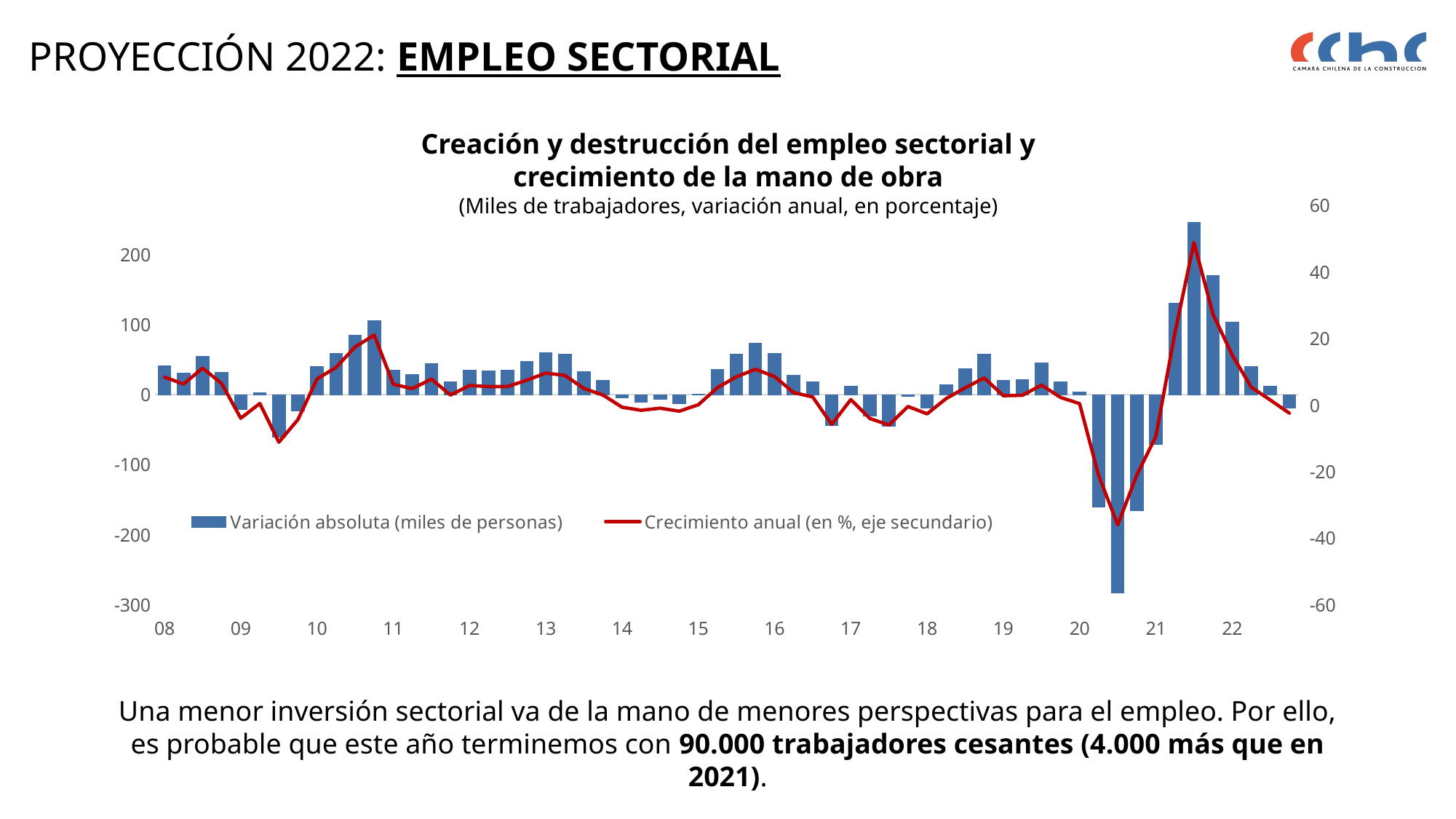
Is the tallest bar in 2021 greater or less than 200 thousand persons? greater In which year does the tallest bar for Variación absoluta appear? 21 Which is larger: the tallest bar in 2021 or the tallest bar in 2011? The tallest bar in 2021 Is the lowest bar in 2020 greater or less than -200 thousand persons? less In which year does the lowest (most negative) bar for Variación absoluta appear? 20 What is the title of the chart? Creación y destrucción del empleo sectorial y crecimiento de la mano de obra Is the peak of the Crecimiento anual line in 2021 greater or less than 40%? greater Which series is plotted on the secondary axis according to the legend? Crecimiento anual (en %, eje secundario) Do the Variación absoluta bars rise or fall from the 2021 peak through 2022? Fall What kind of chart is shown on the slide? A combined bar and line chart How many series does the legend list? 2